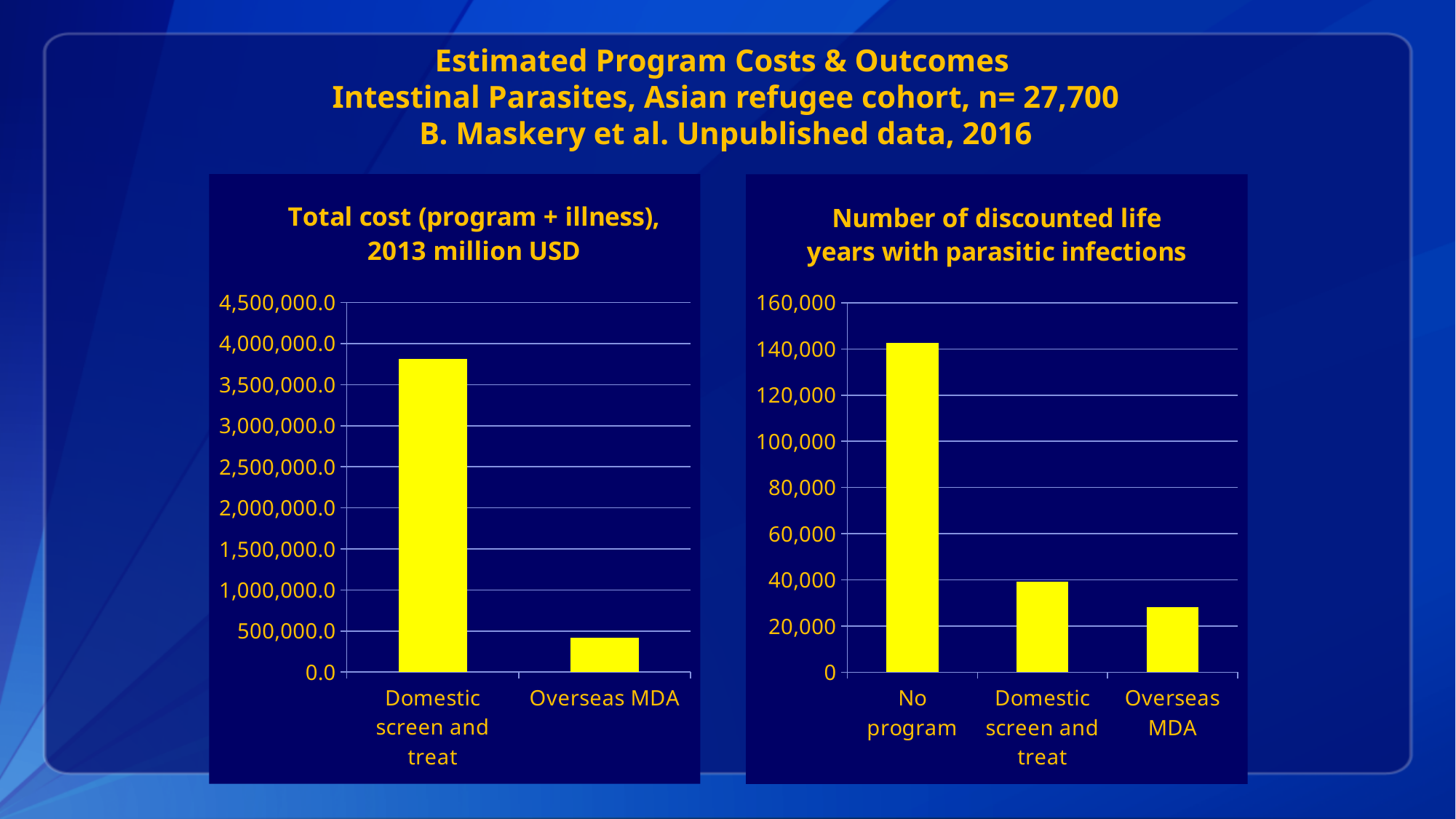
What is the title of the left chart on the slide? Total cost (program + illness), 2013 million USD In the right chart, 'Number of discounted life years with parasitic infections', which is larger: Domestic screen and treat or Overseas MDA? Domestic screen and treat In the left chart, 'Total cost (program + illness), 2013 million USD', is the value for Overseas MDA greater or less than 500,000.0? less In the left chart, 'Total cost (program + illness), 2013 million USD', which category has the lowest value? Overseas MDA In the right chart, 'Number of discounted life years with parasitic infections', which category has the highest value? No program What kind of chart is the right chart, 'Number of discounted life years with parasitic infections'? bar chart How many categories are shown in the left chart, 'Total cost (program + illness), 2013 million USD'? 2 In the left chart, 'Total cost (program + illness), 2013 million USD', is the value for Domestic screen and treat greater or less than 3,500,000.0? greater How many categories are shown in the right chart, 'Number of discounted life years with parasitic infections'? 3 In the right chart, 'Number of discounted life years with parasitic infections', which category has the lowest value? Overseas MDA In the right chart, 'Number of discounted life years with parasitic infections', is the value for No program greater or less than 140,000? greater In the left chart, 'Total cost (program + illness), 2013 million USD', which category has the highest value? Domestic screen and treat